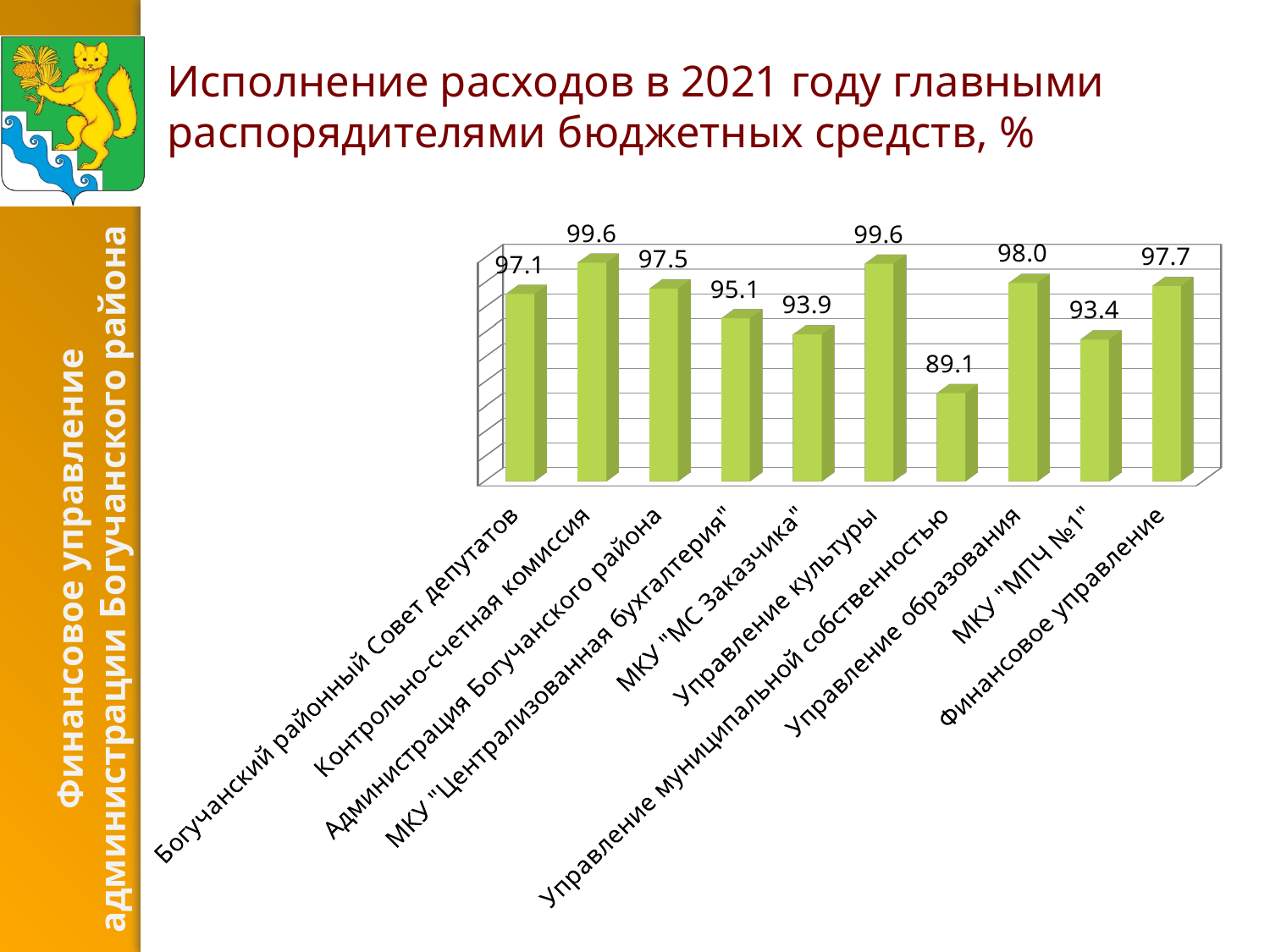
What is the value for Финансовое управление? 97.7 What is the difference between the values for Администрация Богучанского района and Богучанский районный Совет депутатов? 0.4 Which category has the lowest value? Управление муниципальной собственностью How many categories are shown in the chart? 10 Which two categories share the highest value of 99.6? Контрольно-счетная комиссия and Управление культуры What is the difference between the values for Управление культуры and Управление муниципальной собственностью? 10.5 What kind of chart is shown on the slide? Bar chart What is the value for Управление образования? 98.0 What is the value for МКУ "Централизованная бухгалтерия"? 95.1 What is the title of the chart on the slide? Исполнение расходов в 2021 году главными распорядителями бюджетных средств, % Which is larger, the value for МКУ "МС Заказчика" or the value for Управление образования? Управление образования What is the value for МКУ "МПЧ №1"? 93.4